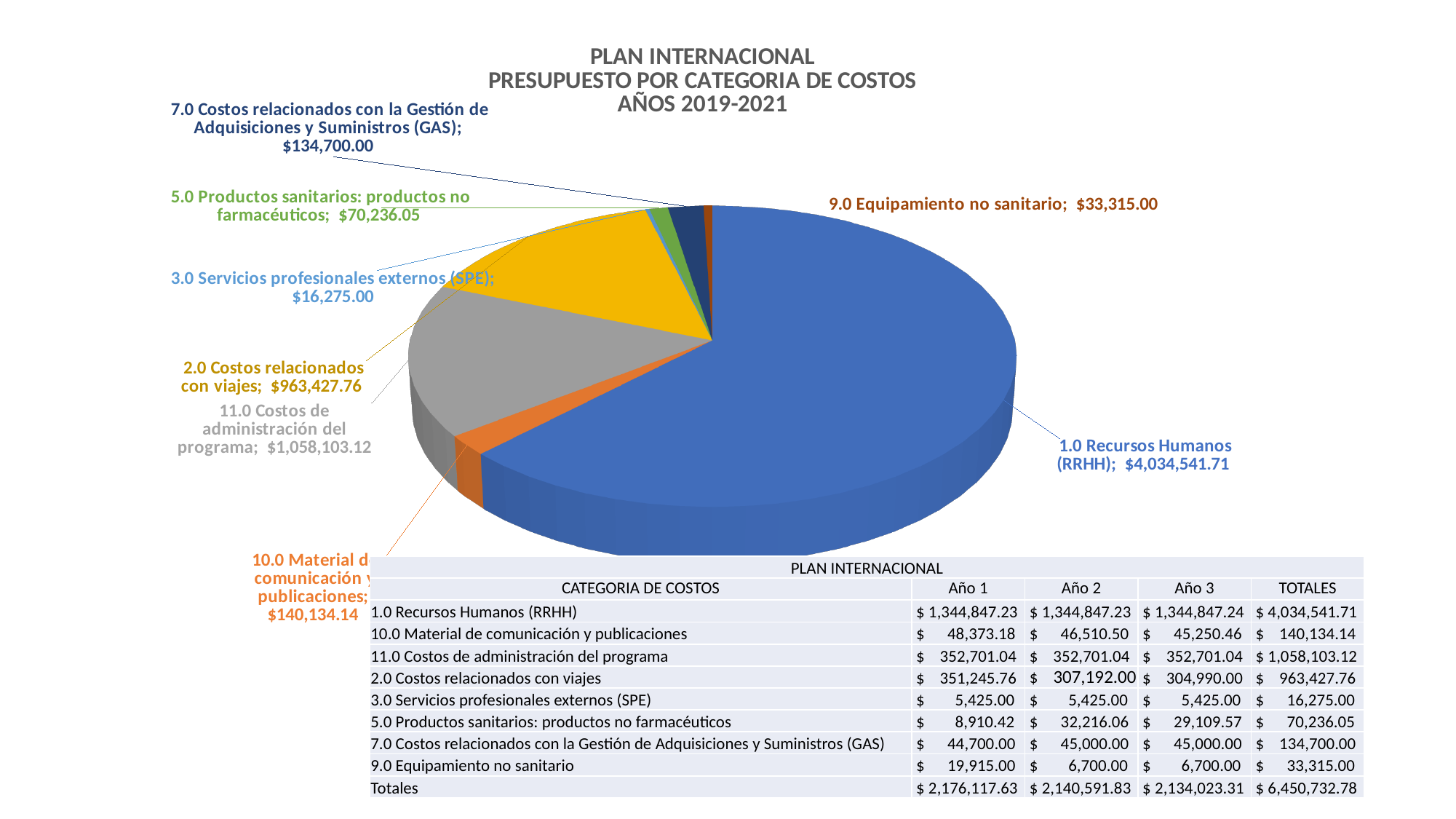
What kind of chart is shown on the slide? Pie chart What is the value for 1.0 Recursos Humanos (RRHH) in the pie chart? $4,034,541.71 What is the value for 11.0 Costos de administración del programa in the pie chart? $1,058,103.12 Which category has the smallest slice in the pie chart? 3.0 Servicios profesionales externos (SPE) How many slices does the pie chart have? 8 What is the value for 9.0 Equipamiento no sanitario in the pie chart? $33,315.00 What is the difference between 10.0 Material de comunicación y publicaciones and 7.0 Costos relacionados con la Gestión de Adquisiciones y Suministros (GAS) in the pie chart? $5,434.14 Which category has the largest slice in the pie chart? 1.0 Recursos Humanos (RRHH) What is the value for 2.0 Costos relacionados con viajes in the pie chart? $963,427.76 What is the title of the pie chart? PLAN INTERNACIONAL PRESUPUESTO POR CATEGORIA DE COSTOS AÑOS 2019-2021 Which is larger in the pie chart: 2.0 Costos relacionados con viajes or 11.0 Costos de administración del programa? 11.0 Costos de administración del programa What is the difference between 5.0 Productos sanitarios: productos no farmacéuticos and 9.0 Equipamiento no sanitario in the pie chart? $36,921.05